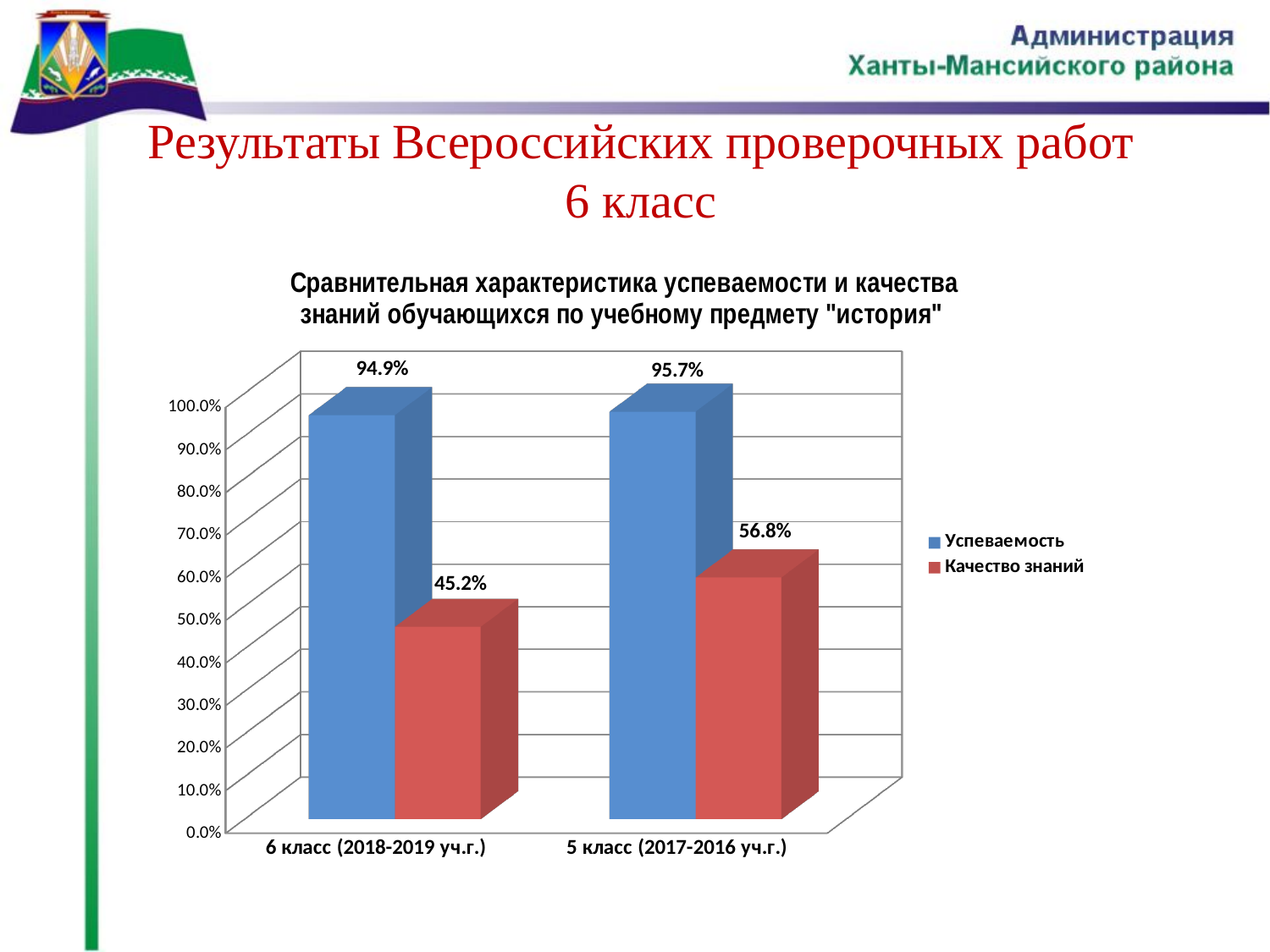
What is the difference between Качество знаний for 5 класс (2017-2016 уч.г.) and for 6 класс (2018-2019 уч.г.)? 11.6% Is the value of Качество знаний for 6 класс (2018-2019 уч.г.) greater or less than 50.0%? less Which bar has the lowest value on the chart? Качество знаний for 6 класс (2018-2019 уч.г.) How many series does the legend list? 2 What is the value of Качество знаний for 6 класс (2018-2019 уч.г.)? 45.2% What is the value of Успеваемость for 5 класс (2017-2016 уч.г.)? 95.7% What is the value of Успеваемость for 6 класс (2018-2019 уч.г.)? 94.9% What is the difference between Успеваемость and Качество знаний for 6 класс (2018-2019 уч.г.)? 49.7% How many categories are shown on the x axis? 2 What is the value of Качество знаний for 5 класс (2017-2016 уч.г.)? 56.8% Which category has the higher value for Качество знаний? 5 класс (2017-2016 уч.г.) What kind of chart is shown on the slide? bar chart